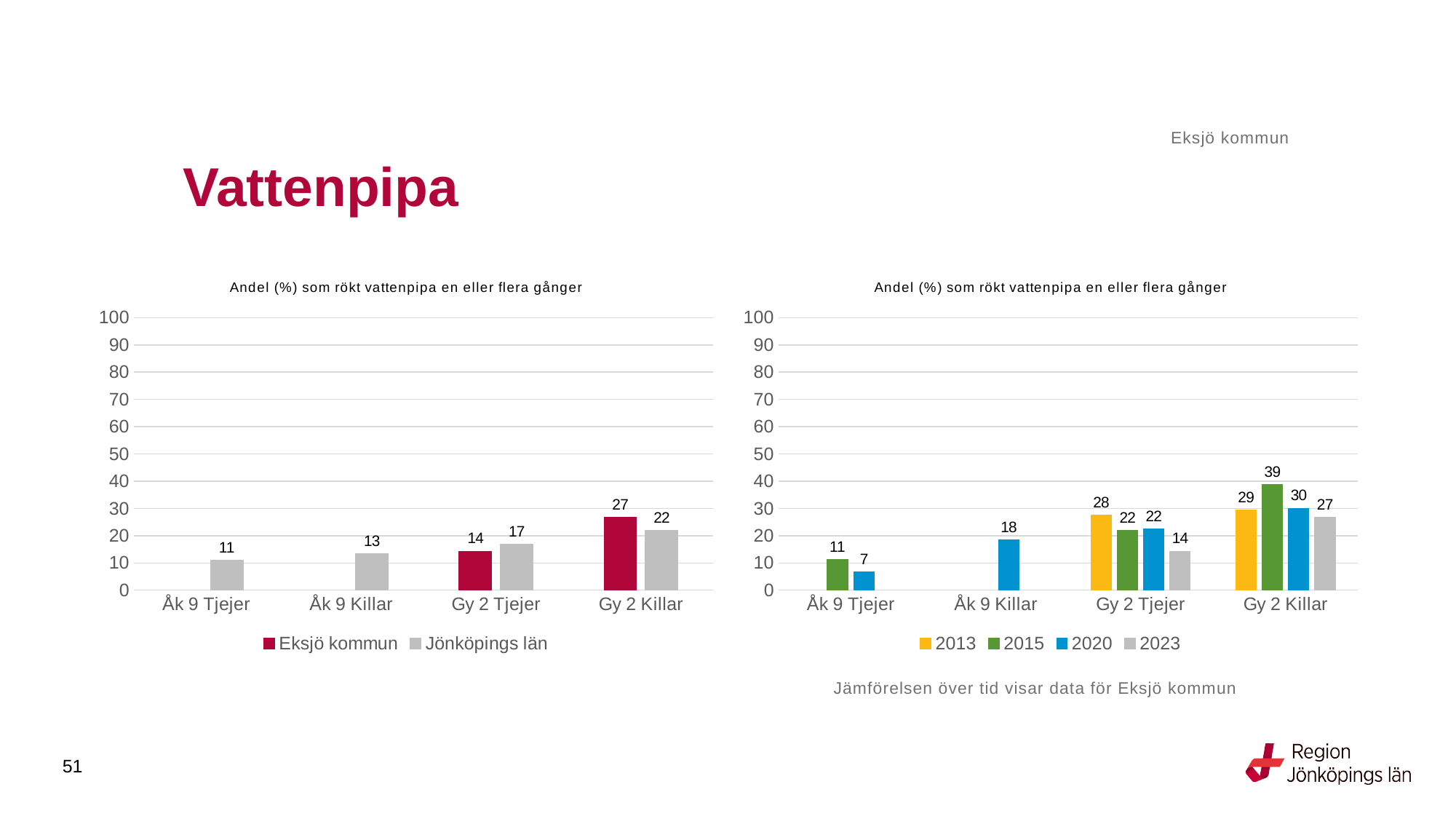
In the left chart, which category has the lowest value for Jönköpings län? Åk 9 Tjejer In the right chart, which is larger for Åk 9 Tjejer: the 2015 value or the 2020 value? 2015 In the left chart, what is the difference between Eksjö kommun and Jönköpings län for Gy 2 Killar? 5 In the left chart, what is the value for Eksjö kommun for Gy 2 Tjejer? 14 In the right chart, what is the difference between the 2013 and 2023 values for Gy 2 Tjejer? 14 In the right chart, which year has the highest value for Gy 2 Killar? 2015 In the right chart, what is the value for 2020 for Åk 9 Killar? 18 In the left chart, how many series does the legend list? 2 In the right chart, what is the value for 2015 for Gy 2 Killar? 39 What kind of chart is the right chart? Bar chart In the left chart, what is the value for Jönköpings län for Gy 2 Killar? 22 In the right chart, how many series does the legend list? 4